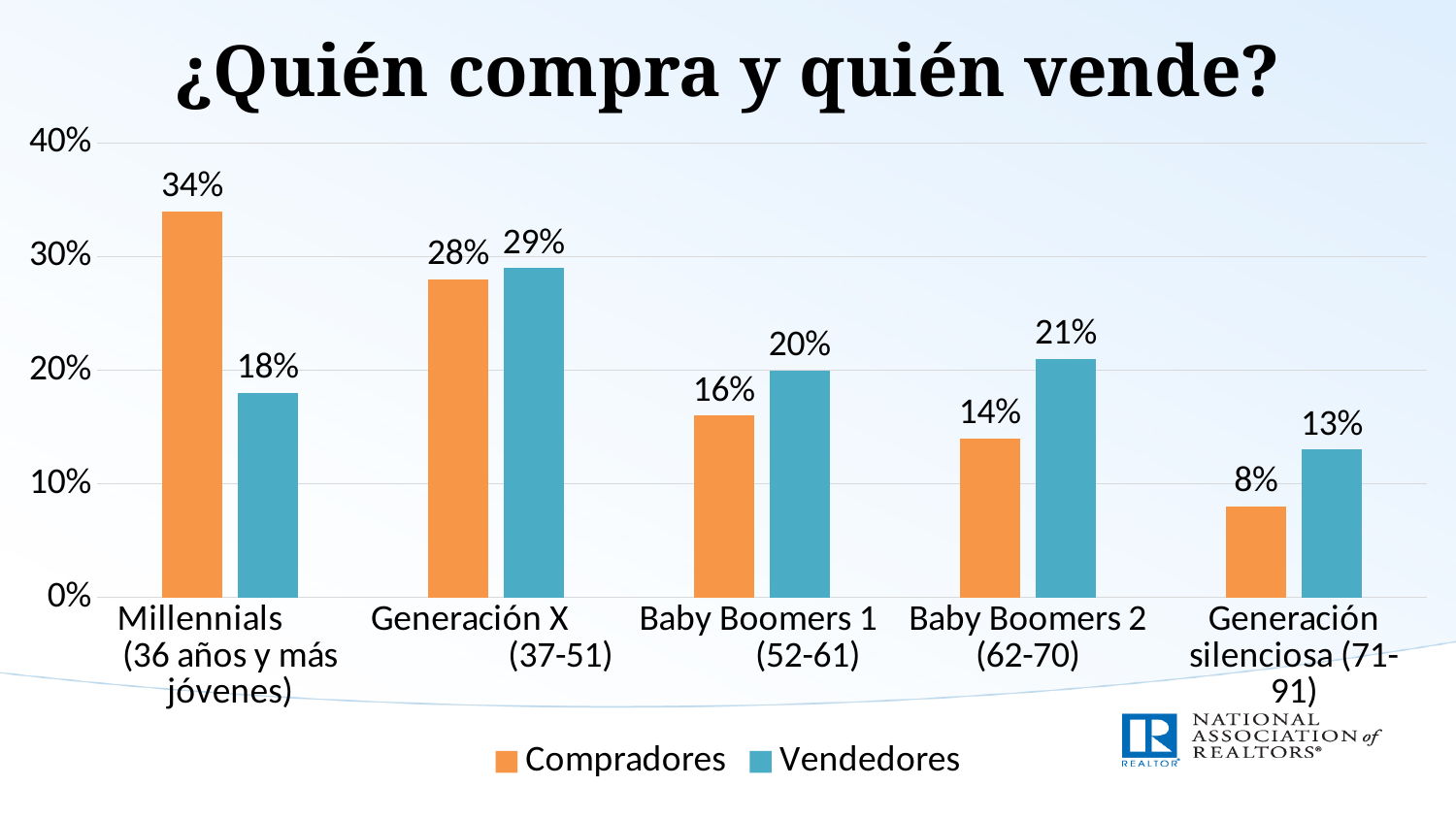
What kind of chart is shown on the slide? Bar chart What is the difference between the Compradores and Vendedores values for Millennials (36 años y más jóvenes)? 16% What is the Compradores value for Millennials (36 años y más jóvenes)? 34% Which category has the highest Compradores value? Millennials (36 años y más jóvenes) What is the Compradores value for Generación silenciosa (71-91)? 8% What is the Vendedores value for Baby Boomers 2 (62-70)? 21% How many categories are shown on the x axis? 5 Which is larger for Baby Boomers 1 (52-61): Compradores or Vendedores? Vendedores Do the Compradores values rise or fall from Millennials to Generación silenciosa along the x axis? Fall What is the title of the chart? ¿Quién compra y quién vende? How many series does the legend list? 2 Which category has the lowest Vendedores value? Generación silenciosa (71-91)